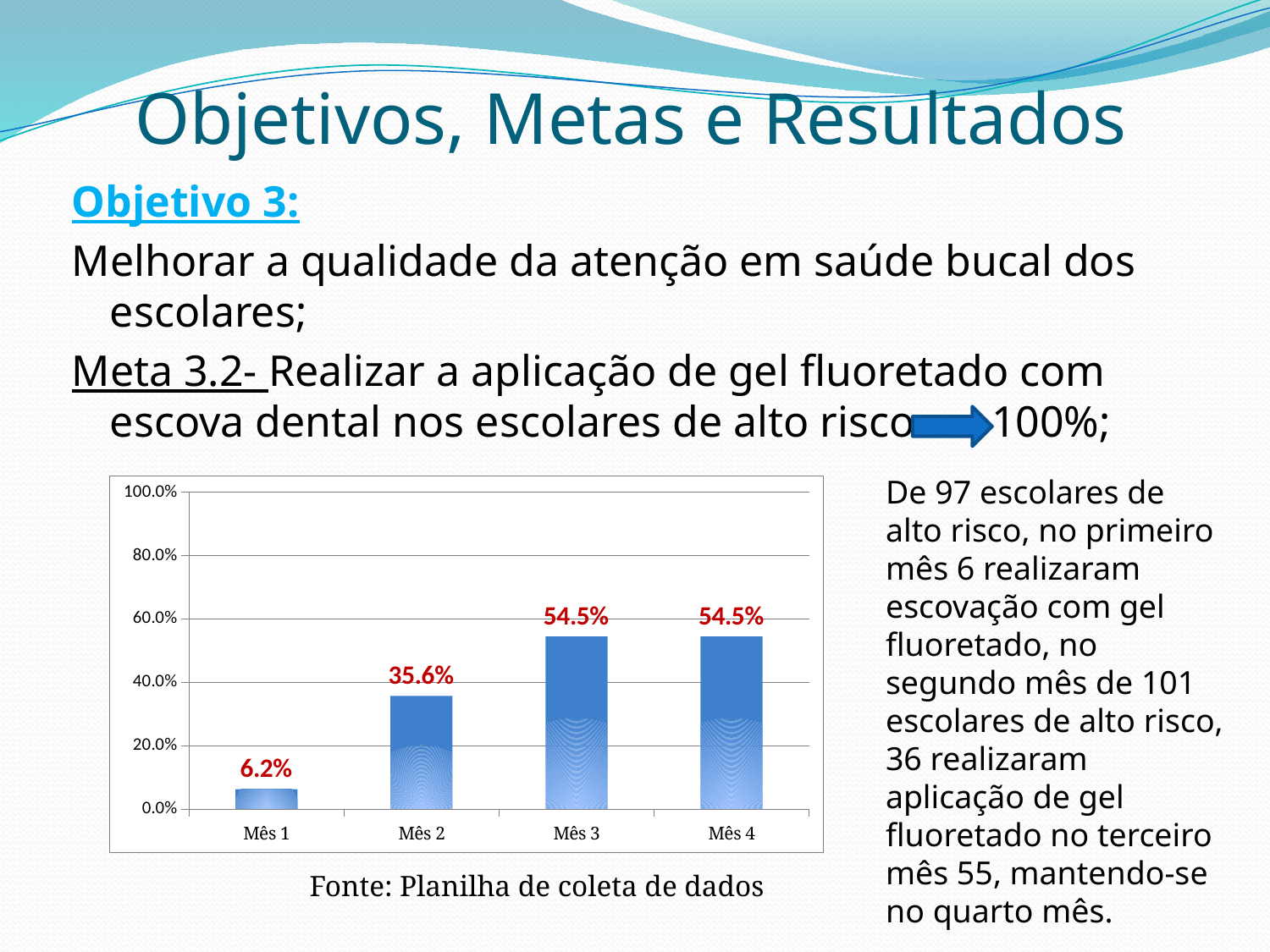
Which is larger, the value for Mês 2 or the value for Mês 3? Mês 3 What is the value for Mês 1? 6.2% What is the value for Mês 2? 35.6% Which month has the lowest value? Mês 1 What is the value for Mês 3? 54.5% What is the difference between the values for Mês 2 and Mês 1? 29.4% Do the values rise or fall from Mês 1 to Mês 3? rise How many months are shown on the x axis? 4 What is the difference between the values for Mês 3 and Mês 2? 18.9% Is the value for Mês 4 greater or less than 40.0%? greater What kind of chart is shown on the slide? bar chart What is the highest value shown on the y axis? 100.0%